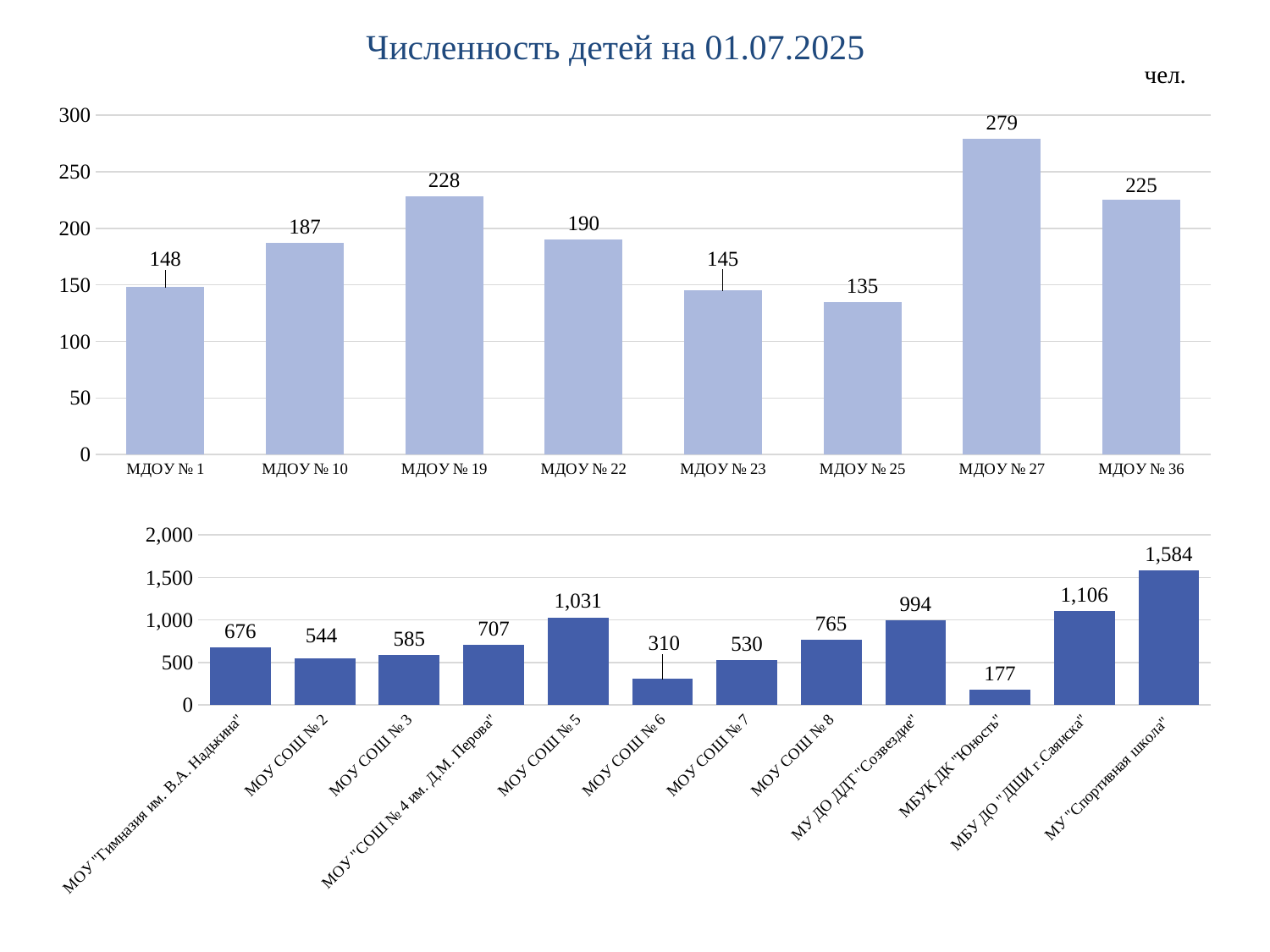
In the bottom chart, which category has the lowest value? МБУК ДК "Юность" What type of chart is the top chart? Bar chart In the bottom chart, what is the difference between the values for МБУ ДО "ДШИ г.Саянска" and МУ ДО ДДТ "Созвездие"? 112 In the bottom chart, which is larger: the value for МОУ СОШ № 8 or the value for МОУ СОШ № 3? МОУ СОШ № 8 In the bottom chart, which category has the highest value? МУ "Спортивная школа" In the bottom chart, what is the value for МОУ СОШ № 5? 1,031 In the top chart, what is the value for МДОУ № 19? 228 In the top chart, which category has the lowest value? МДОУ № 25 In the top chart, how many categories are shown? 8 In the top chart, which category has the highest value? МДОУ № 27 In the bottom chart, how many categories are shown? 12 In the top chart, what is the difference between the values for МДОУ № 27 and МДОУ № 1? 131